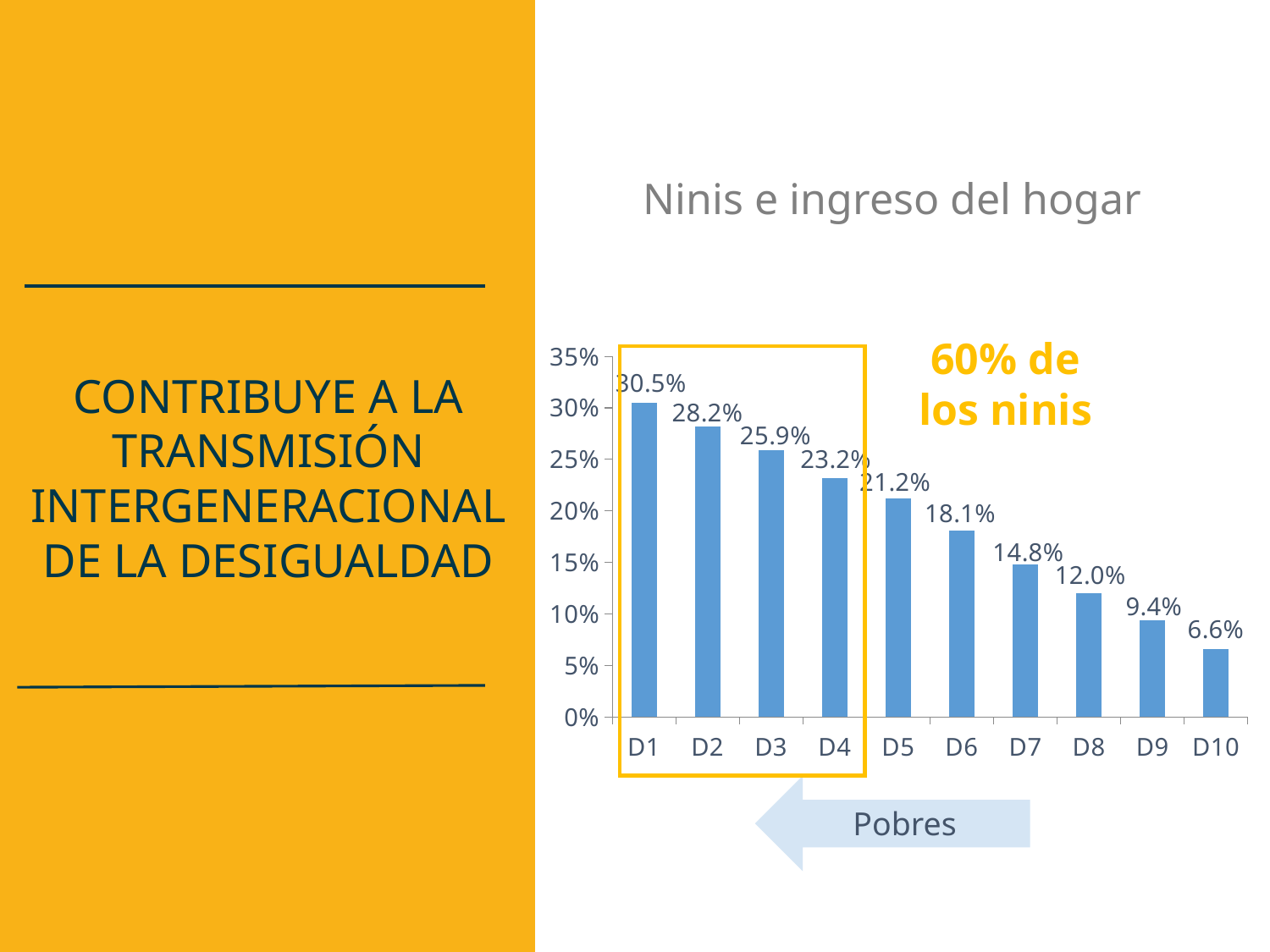
How many categories are shown on the x axis? 10 Which category has the highest value? D1 What is the value for D1? 30.5% Which is larger, the value for D3 or the value for D7? D3 What is the value for D10? 6.6% What is the difference between the values for D1 and D10? 23.9% Do the values rise or fall from D1 to D10? fall What is the difference between the values for D4 and D5? 2.0% Which category has the lowest value? D10 What kind of chart is this? bar chart What is the value for D6? 18.1% Is the value for D8 greater or less than 15%? less